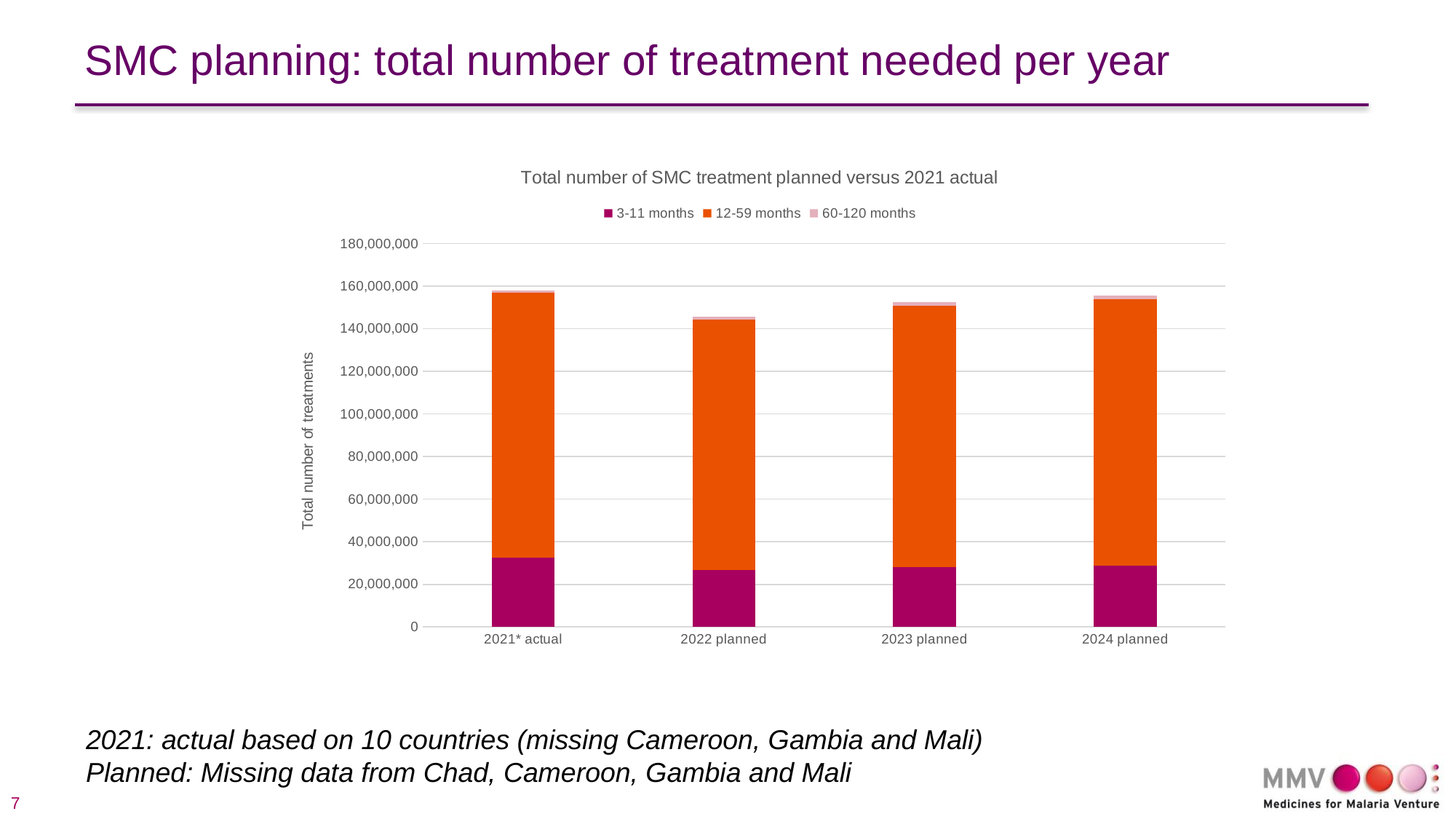
Which category has the highest total number of treatments? 2021* actual Which category has the largest value for the 3-11 months series? 2021* actual Is the total number of treatments for 2022 planned greater or less than 160,000,000? less How many categories are shown on the x axis of the chart? 4 Is the total number of treatments for 2021* actual greater or less than 140,000,000? greater What kind of chart is shown on the slide? Stacked bar chart Which category has the lowest total number of treatments? 2022 planned How many series does the chart legend list? 3 Is the value for the 3-11 months series in 2021* actual greater or less than 20,000,000? greater Which has a larger total number of treatments, 2022 planned or 2024 planned? 2024 planned What is the title of the chart? Total number of SMC treatment planned versus 2021 actual Which has a larger total number of treatments, 2021* actual or 2022 planned? 2021* actual